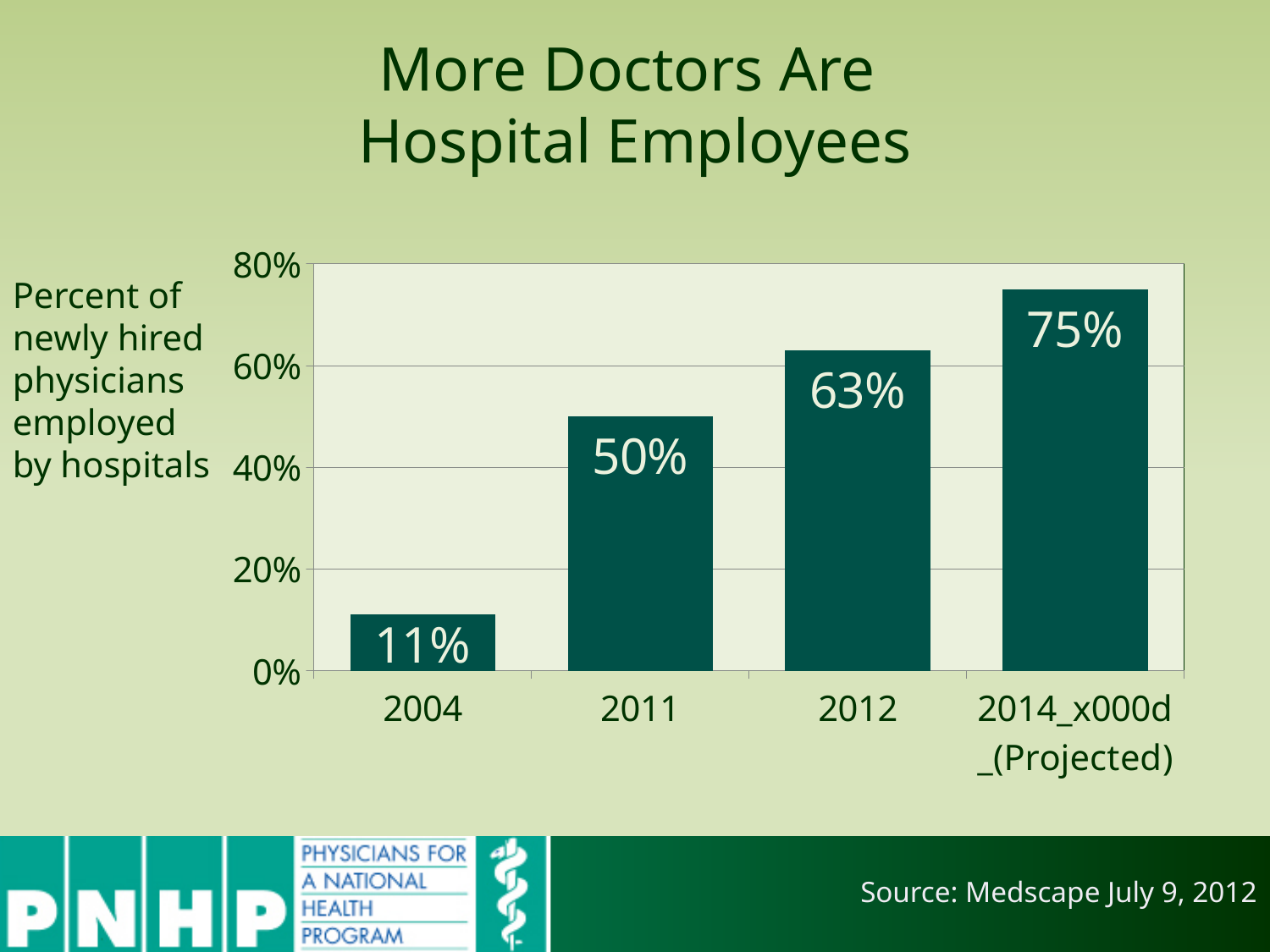
What is the value shown for 2011? 50% What percent of newly hired physicians were employed by hospitals in 2004? 11% What is the value shown for 2012? 63% What is the projected value for 2014? 75% Which year has the highest percentage of newly hired physicians employed by hospitals? 2014 (Projected) What is the difference between the 2014 projected value and the 2011 value? 25% What kind of chart is shown on the slide? Bar chart What is the difference between the 2012 value and the 2004 value? 52% Which is larger, the value for 2011 or the value for 2012? 2012 Do the values rise or fall from 2004 to 2014 (Projected)? Rise Which year has the lowest percentage of newly hired physicians employed by hospitals? 2004 How many years are shown on the x axis of the chart? 4